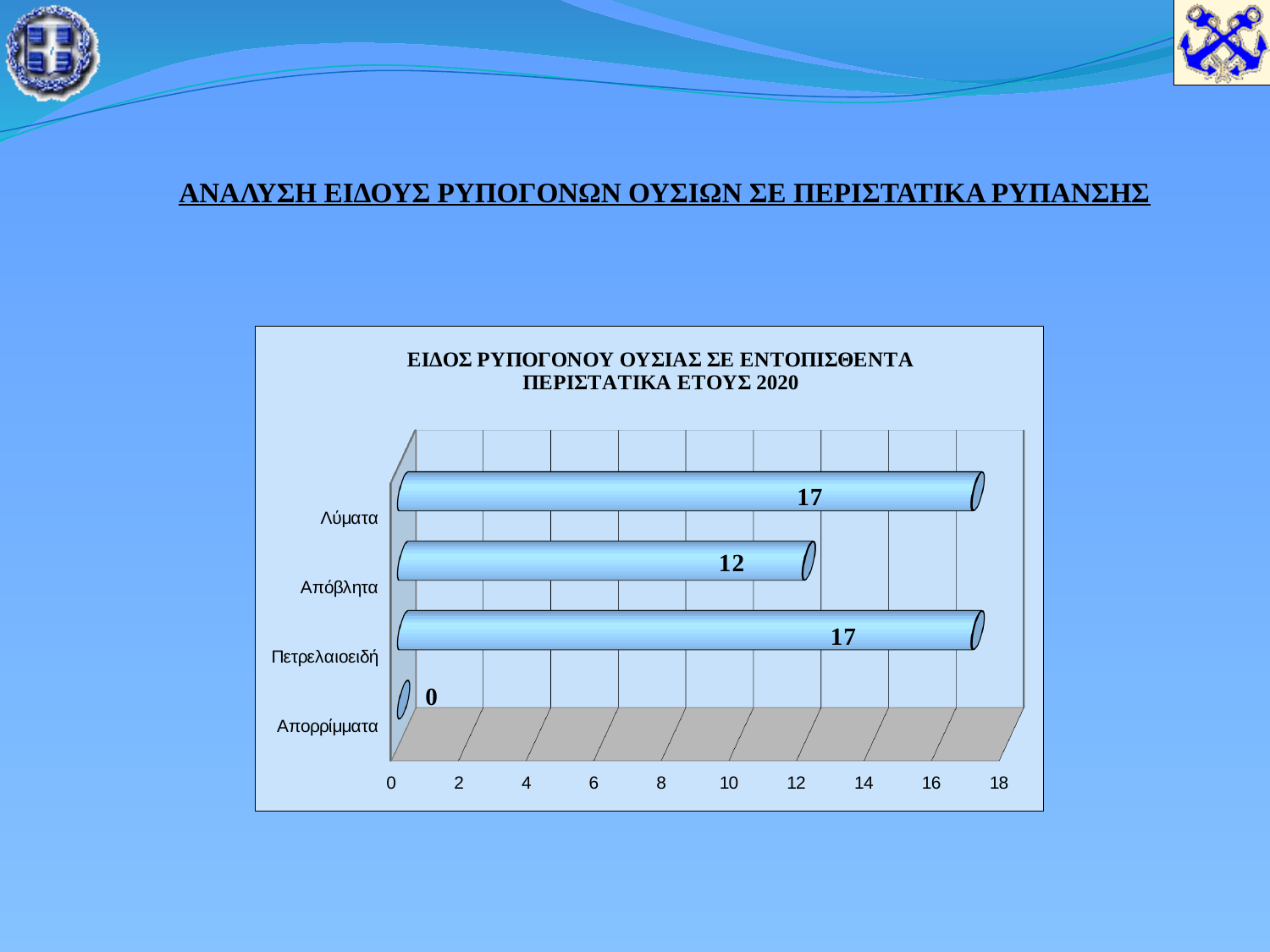
What is the value for Πετρελαιοειδή? 17 Which is larger, the value for Απόβλητα or the value for Πετρελαιοειδή? Πετρελαιοειδή What is the maximum value shown on the horizontal axis? 18 What is the difference between the values for Λύματα and Απόβλητα? 5 Is the value for Απόβλητα greater or less than 10? greater What is the value for Λύματα? 17 What is the title of the chart? ΕΙΔΟΣ ΡΥΠΟΓΟΝΟΥ ΟΥΣΙΑΣ ΣΕ ΕΝΤΟΠΙΣΘΕΝΤΑ ΠΕΡΙΣΤΑΤΙΚΑ ΕΤΟΥΣ 2020 How many categories are shown in the chart? 4 What is the value for Απόβλητα? 12 What kind of chart is shown on the slide? Bar chart What is the value for Απορρίμματα? 0 Which category has the lowest value? Απορρίμματα